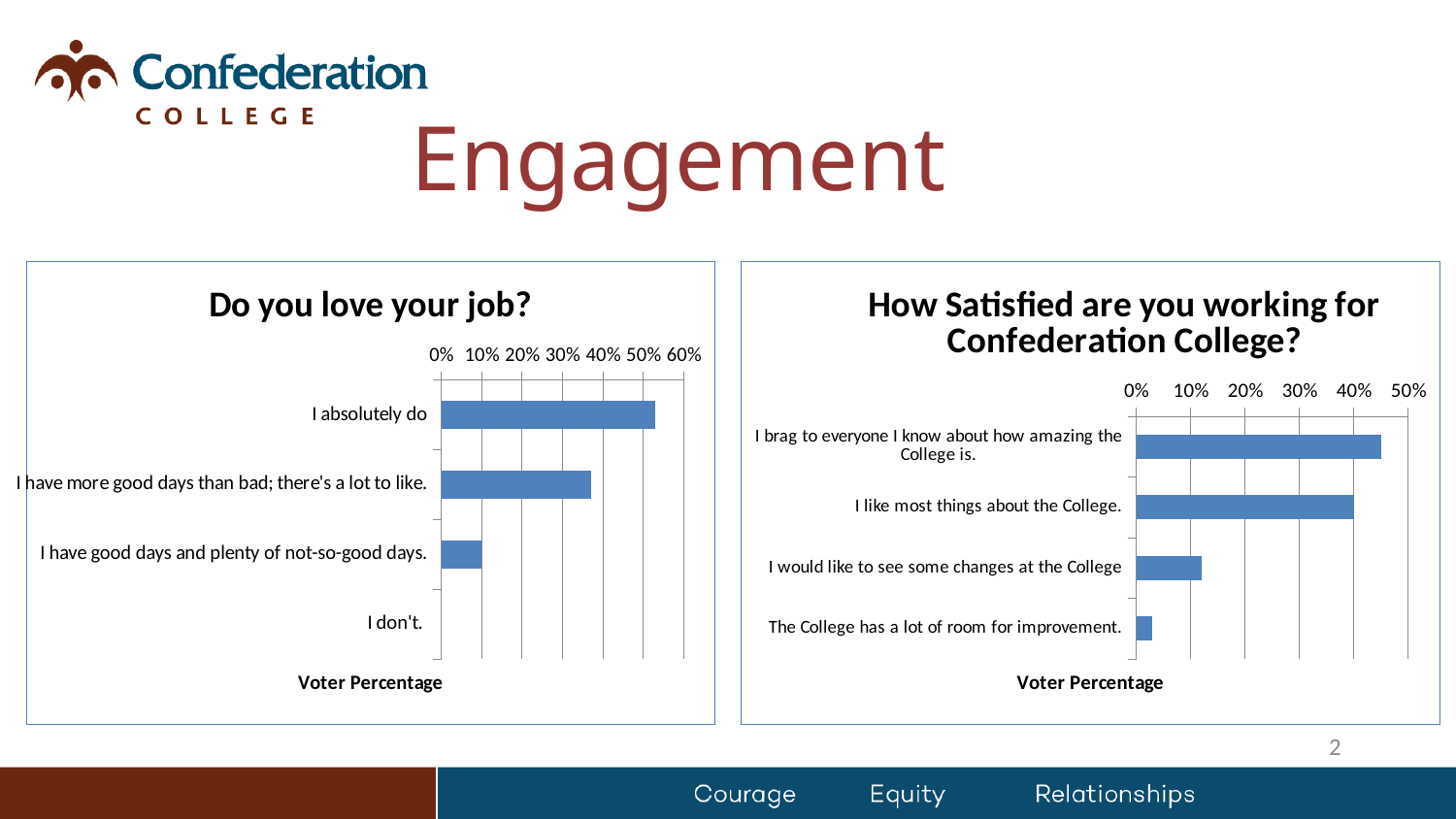
In the 'How Satisfied are you working for Confederation College?' chart, is the value for 'I would like to see some changes at the College' greater or less than 20%? less How many response categories are shown in the 'Do you love your job?' chart? 4 In the 'How Satisfied are you working for Confederation College?' chart, which response has the highest voter percentage? I brag to everyone I know about how amazing the College is. In the 'How Satisfied are you working for Confederation College?' chart, is the value for 'I like most things about the College.' greater or less than 30%? greater In the 'Do you love your job?' chart, is the value for 'I have good days and plenty of not-so-good days.' greater or less than 20%? less In the 'Do you love your job?' chart, which is larger: 'I have more good days than bad; there's a lot to like.' or 'I have good days and plenty of not-so-good days.'? I have more good days than bad; there's a lot to like. In the 'Do you love your job?' chart, which response has the highest voter percentage? I absolutely do In the 'Do you love your job?' chart, which response has the lowest voter percentage? I don't. In the 'How Satisfied are you working for Confederation College?' chart, which response has the lowest voter percentage? The College has a lot of room for improvement. What is the axis title shown below the bars in the 'How Satisfied are you working for Confederation College?' chart? Voter Percentage What kind of chart is the 'Do you love your job?' chart? bar chart